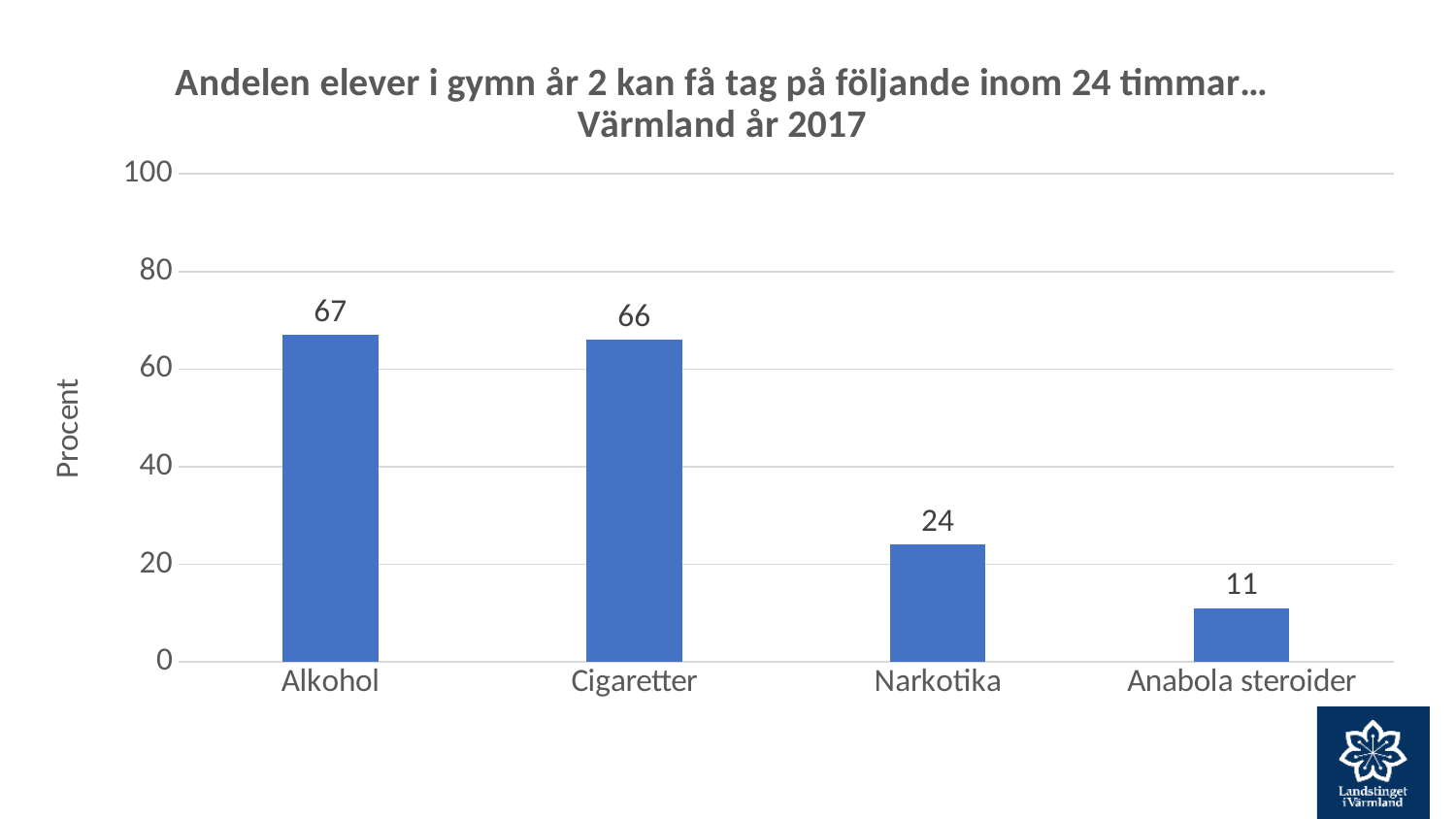
What is the difference between the values for Alkohol and Anabola steroider? 56 Is the value for Cigaretter greater or less than 60? greater How many categories are shown on the x axis? 4 Do the values rise or fall from left to right along the x axis? fall Which category has the lowest value? Anabola steroider What is the label of the y axis? Procent What is the value for Narkotika? 24 What kind of chart is shown on the slide? bar chart Which is larger, the value for Narkotika or the value for Anabola steroider? Narkotika What is the value for Anabola steroider? 11 What is the difference between the values for Cigaretter and Narkotika? 42 What is the value for Alkohol? 67